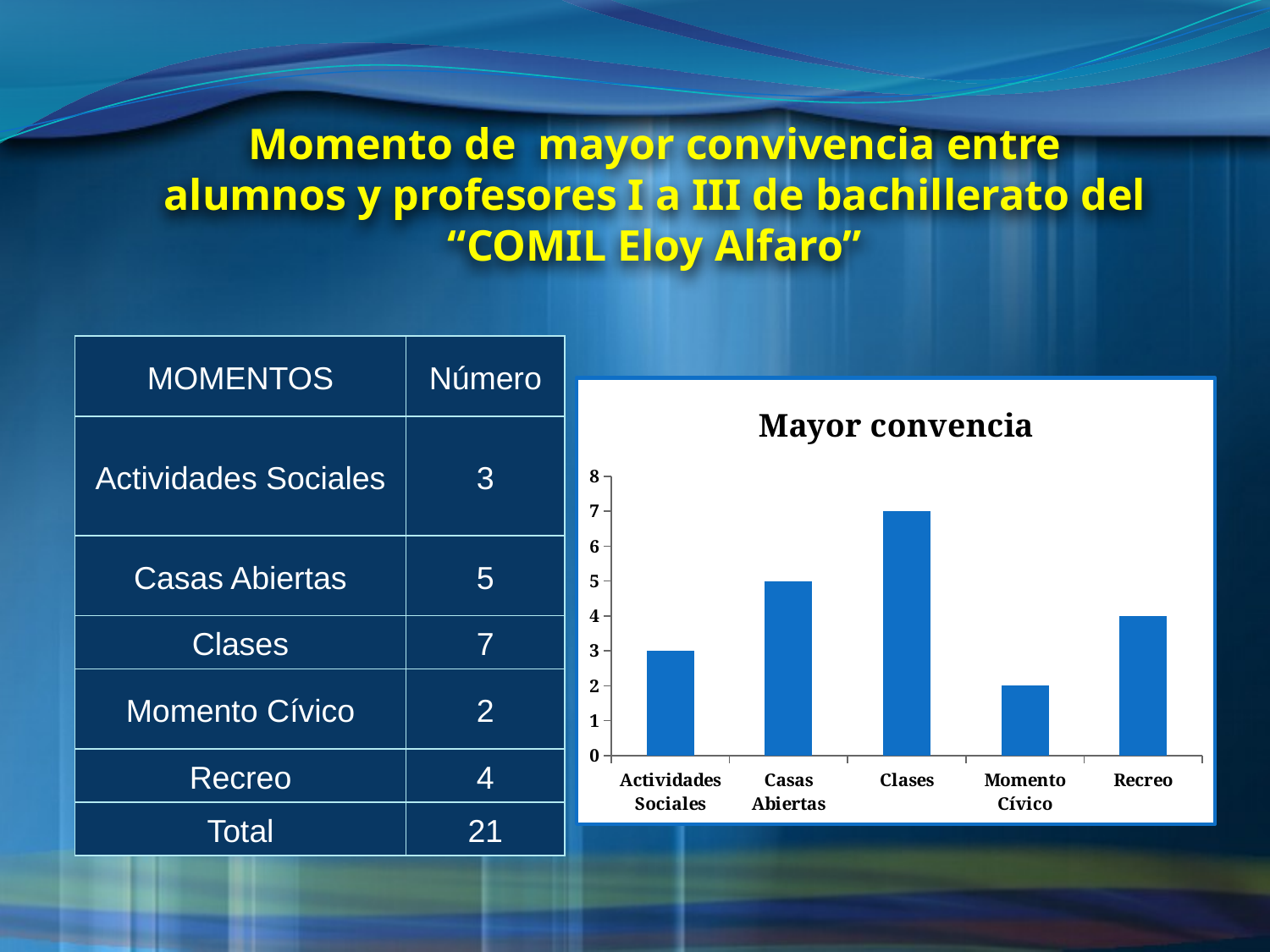
How many categories are shown on the x axis of the chart? 5 What is the title of the chart? Mayor convencia Which category has the highest bar in the chart? Clases What is the difference between the values for Clases and Momento Cívico? 5 What is the value for Recreo in the chart? 4 Which is larger, the value for Casas Abiertas or the value for Recreo? Casas Abiertas What type of chart is shown on the slide? bar chart What is the value for Actividades Sociales in the chart? 3 Which category has the lowest bar in the chart? Momento Cívico Is the value for Clases greater or less than 6? greater What is the value for Clases in the chart? 7 What is the value for Casas Abiertas in the chart? 5